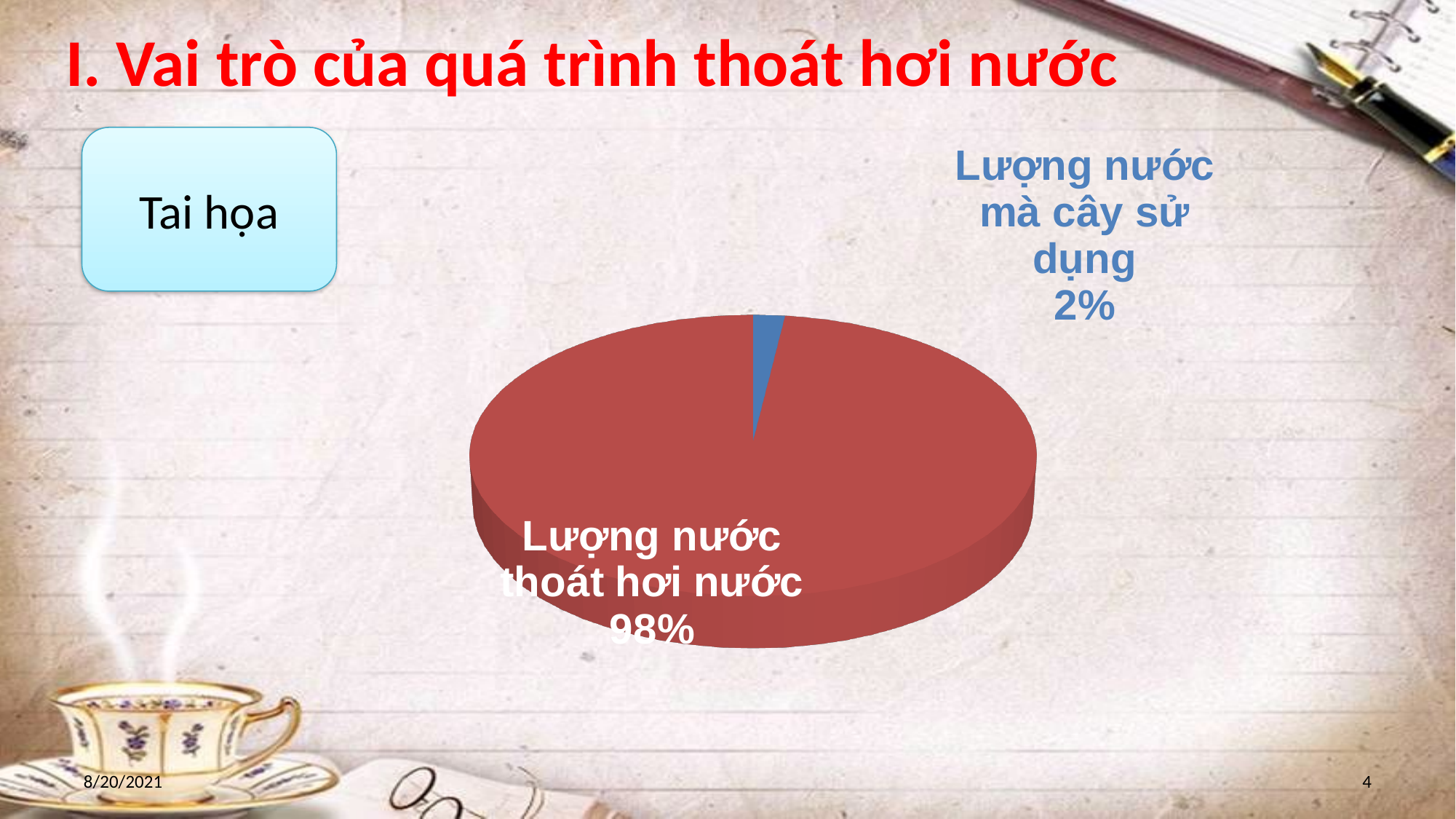
What percentage is shown for "Lượng nước thoát hơi nước"? 98% Which slice of the pie chart is the smallest? Lượng nước mà cây sử dụng Which is larger: "Lượng nước thoát hơi nước" or "Lượng nước mà cây sử dụng"? Lượng nước thoát hơi nước What colour is the slice for "Lượng nước mà cây sử dụng"? blue What kind of chart is shown on the slide? pie chart How many slices does the pie chart have? 2 What colour is the slice for "Lượng nước thoát hơi nước"? red What percentage is shown for "Lượng nước mà cây sử dụng"? 2% What is the difference in percentage points between "Lượng nước thoát hơi nước" and "Lượng nước mà cây sử dụng"? 96 Which slice of the pie chart is the largest? Lượng nước thoát hơi nước What share of the pie does "Lượng nước mà cây sử dụng" represent? 2%